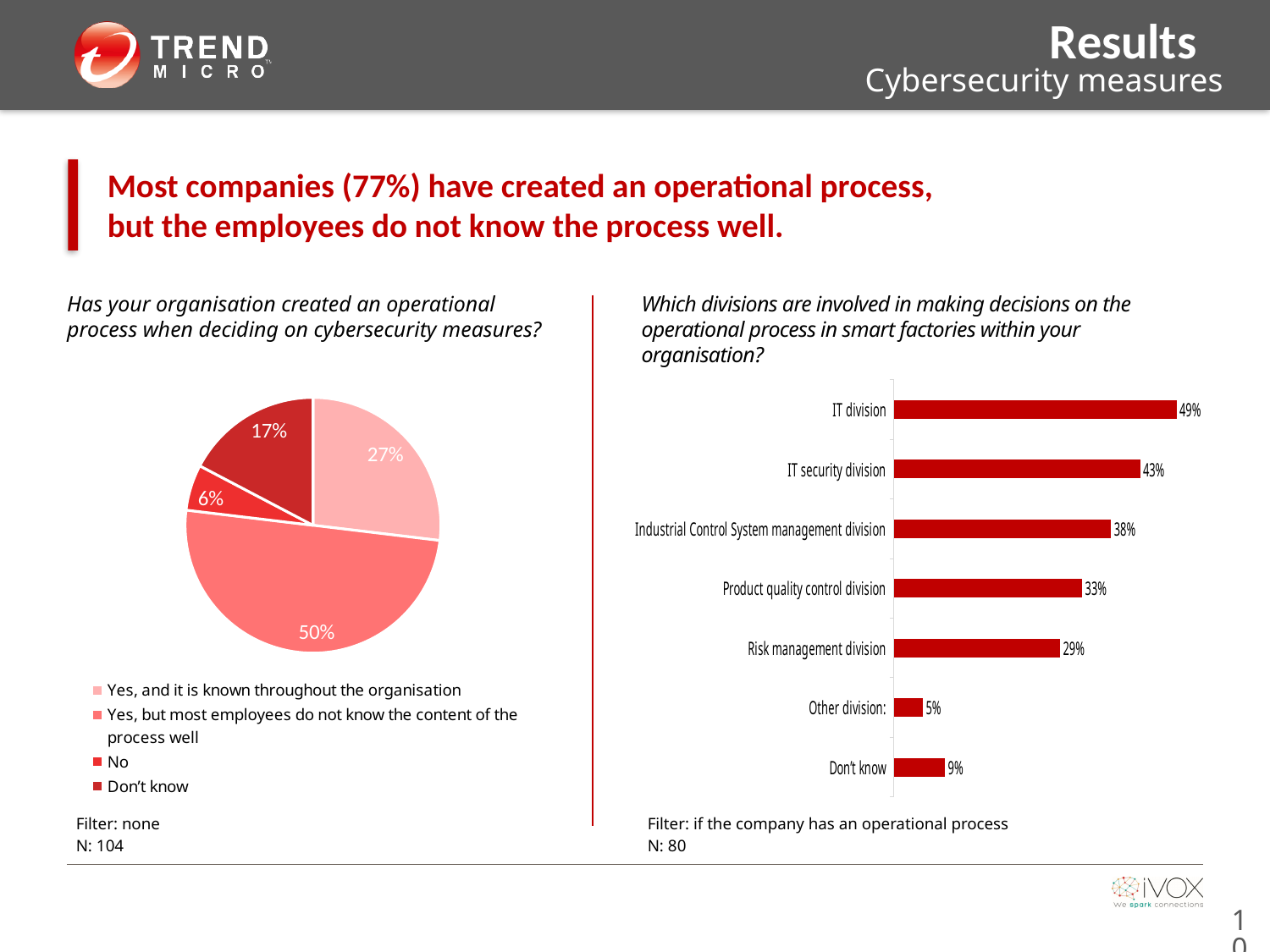
What kind of chart is the chart on the right of the slide? Bar chart In the pie chart on the left, what share is 'No'? 6% How many categories are shown in the bar chart on the right? 7 In the bar chart on the right, which division has the highest value? IT division In the bar chart on the right, what is the value for Risk management division? 29% In the bar chart on the right, what is the value for IT division? 49% In the bar chart on the right, which category has the lowest value? Other division In the bar chart on the right, which is larger: Industrial Control System management division or Risk management division? Industrial Control System management division In the pie chart on the left, what share is 'Yes, but most employees do not know the content of the process well'? 50% How many entries does the legend of the pie chart on the left list? 4 In the bar chart on the right, what is the difference between IT security division and Product quality control division? 10% In the pie chart on the left, which is larger: 'Yes, and it is known throughout the organisation' or 'Don't know'? Yes, and it is known throughout the organisation